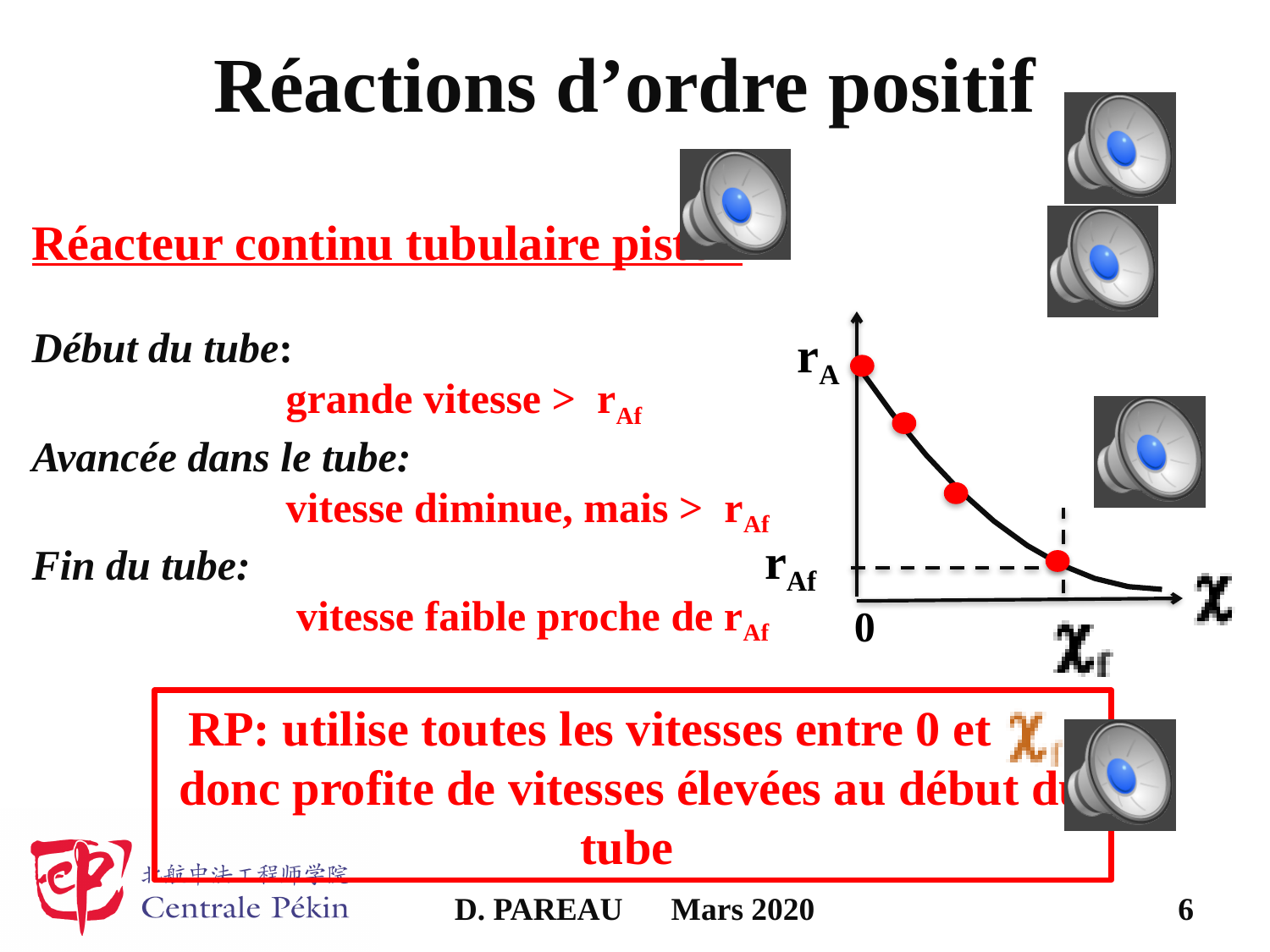
Does the curve rise or fall as χ increases along the x axis? fall At which value of χ does the curve reach the level r_Af marked by the dashed line? χ_f What label is written on the horizontal axis of the chart? χ What label is written on the vertical axis of the chart? r_A What kind of chart is shown on the slide? line chart Which red point on the curve has the highest value of r_A, the one at χ = 0 or the one at χ_f? the one at χ = 0 How many red data points are marked on the curve? 4 What value is marked at the origin of the horizontal axis? 0